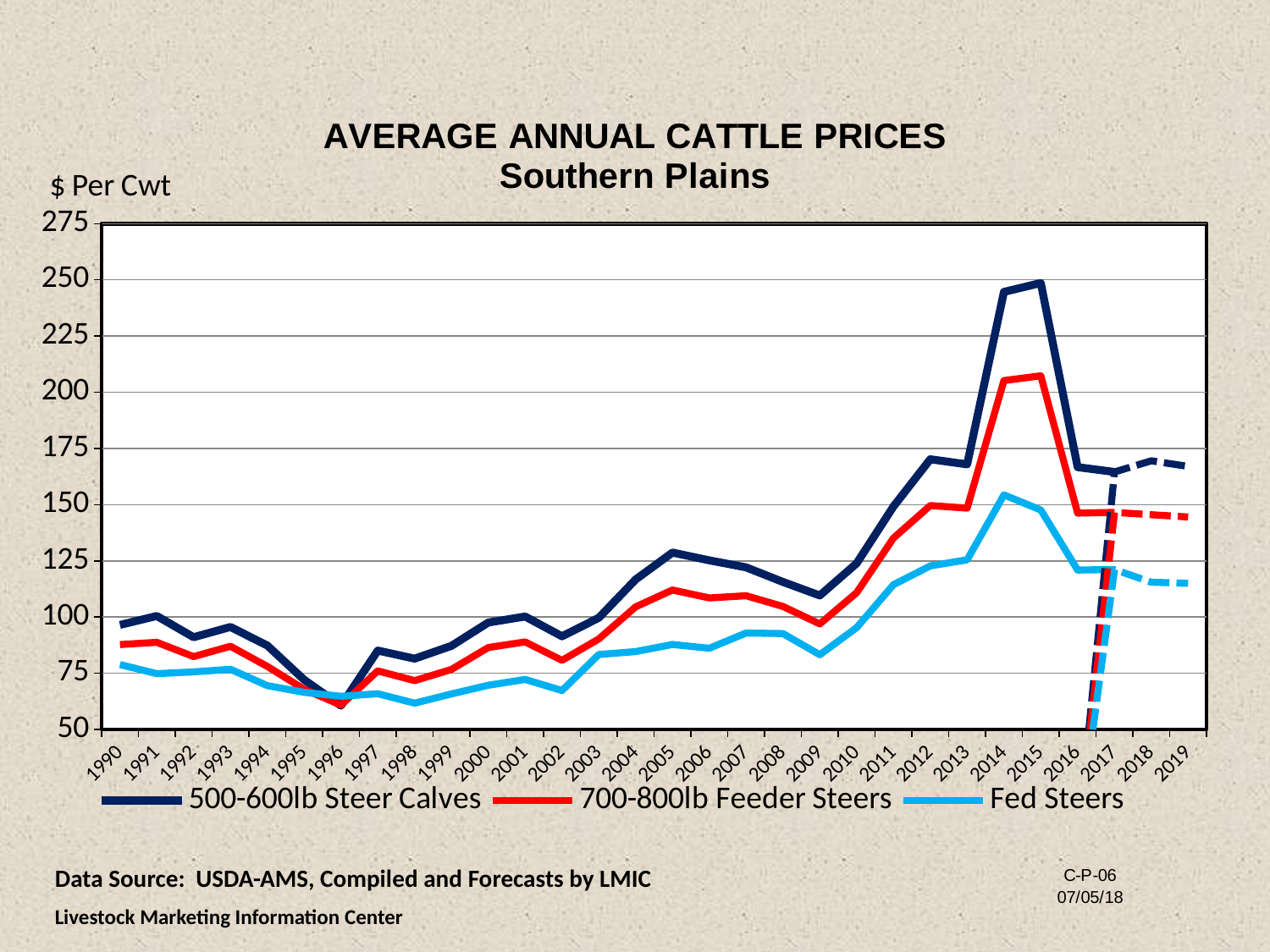
What is the title of the chart? AVERAGE ANNUAL CATTLE PRICES Southern Plains How many series does the legend list? 3 In which year does the 500-600lb Steer Calves series reach its highest value? 2015 Is the value for 700-800lb Feeder Steers in 2014 greater or less than 175? greater In which year does the 500-600lb Steer Calves series reach its lowest value? 1996 In 2015, which is larger: the value for 500-600lb Steer Calves or the value for Fed Steers? 500-600lb Steer Calves What kind of chart is shown on the slide? Line chart Is the value for 500-600lb Steer Calves in 2015 greater or less than 225? greater How many years are shown along the x axis? 30 Is the value for Fed Steers in 1998 greater or less than 75? less Do the 500-600lb Steer Calves values rise or fall from 2010 to 2014? Rise What unit label is shown on the y axis? $ Per Cwt